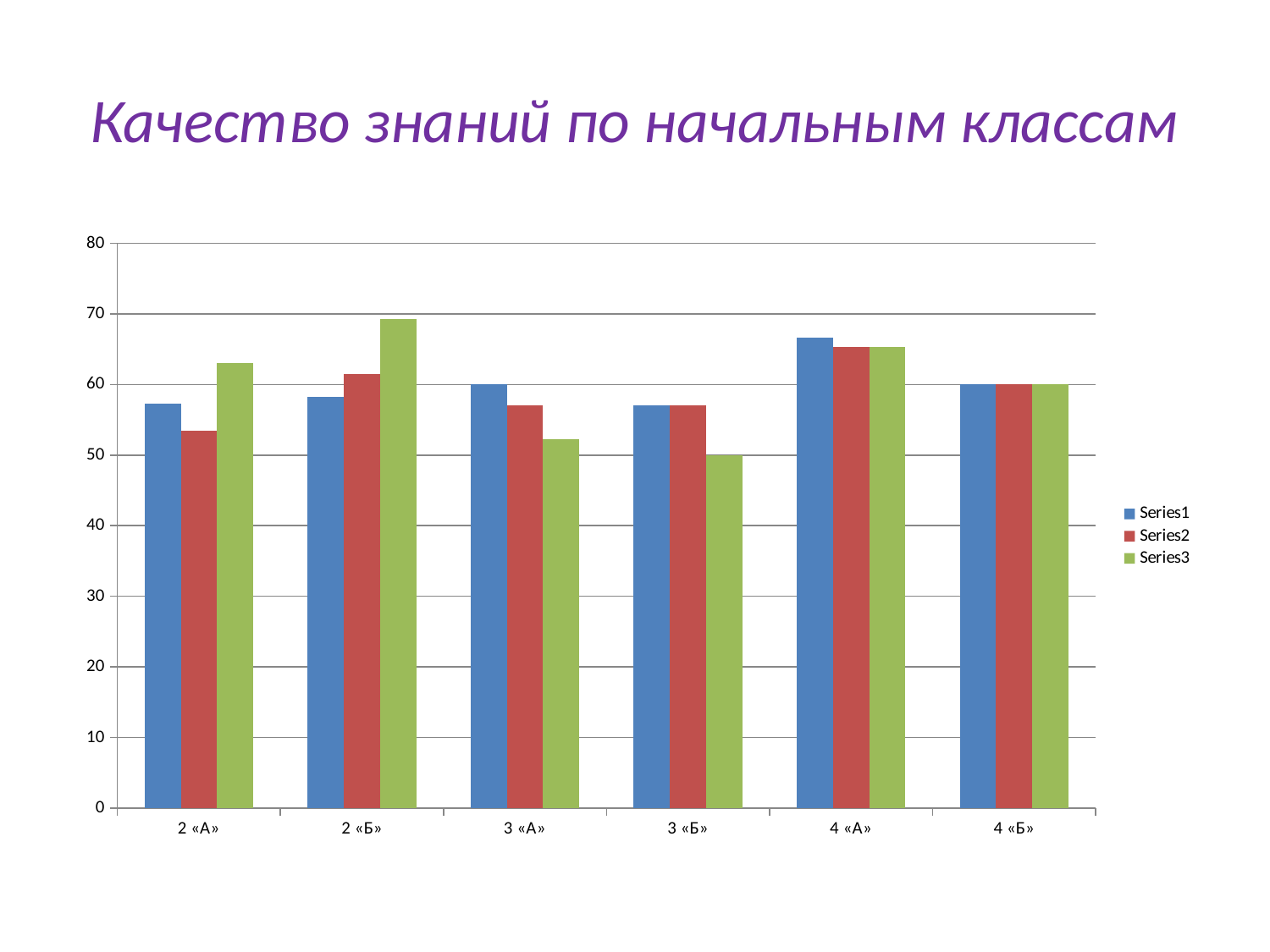
What kind of chart is shown on the slide? bar chart How many series does the legend list? 3 What is the title of the slide? Качество знаний по начальным классам What is the value of Series1 for 4 «Б»? 60 Is the value of Series3 for 2 «А» greater or less than 60? greater For which class is the Series3 value highest? 2 «Б» Is the value of Series2 for 2 «А» greater or less than 60? less How many classes (categories) are shown on the x axis? 6 For which class is the Series2 value lowest? 2 «А» What is the value of Series3 for 3 «Б»? 50 For 3 «А», which is larger: Series1 or Series3? Series1